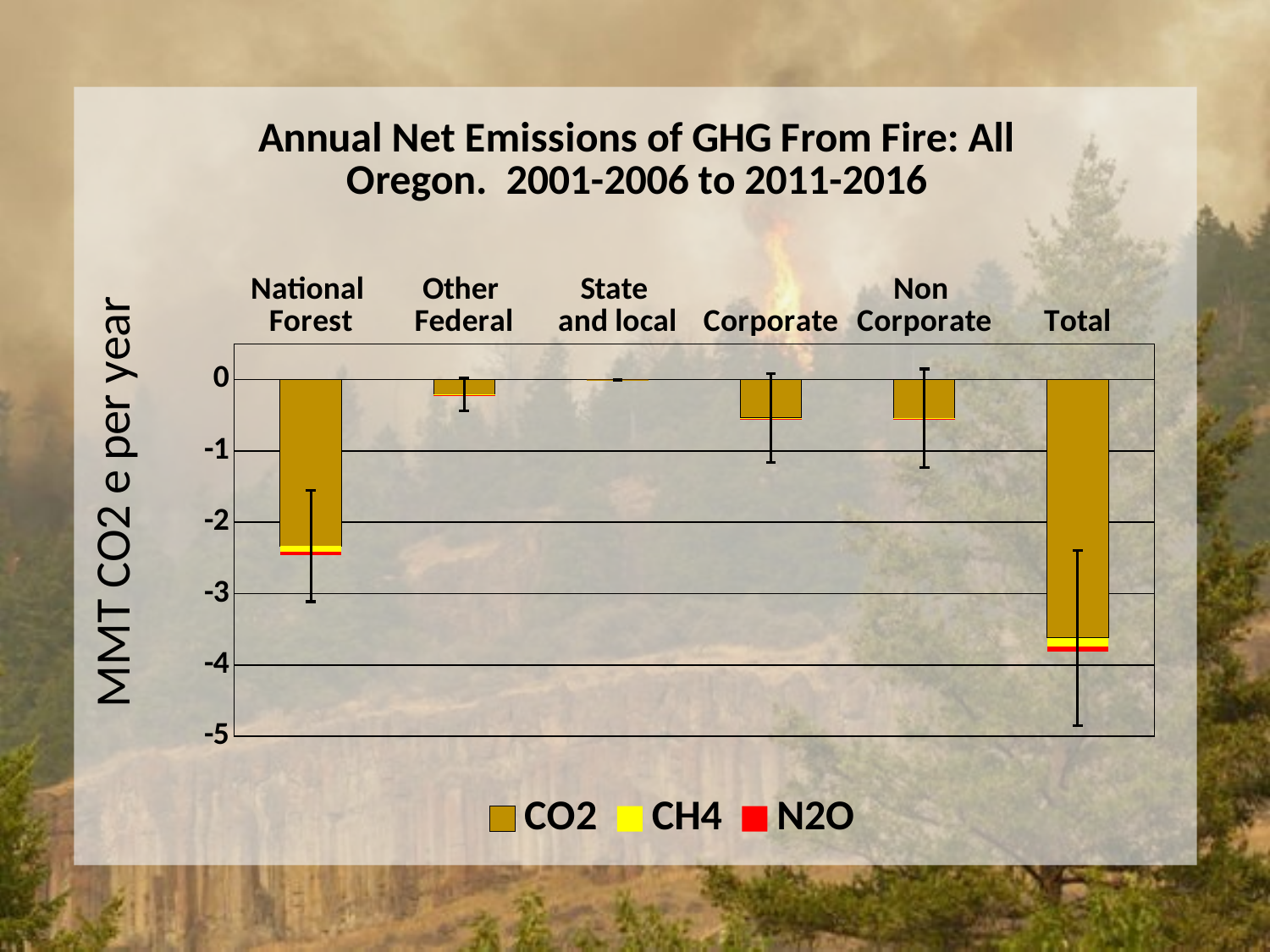
What kind of chart is shown on the slide? bar chart How many series does the legend list? 3 Which bar extends further below zero, National Forest or Other Federal? National Forest Is the value for National Forest greater or less than -2? less What are the three series listed in the chart legend? CO2, CH4, N2O What is the label on the vertical axis of the chart? MMT CO2 e per year Is the value for Total greater or less than -3? less Is the value for Corporate greater or less than -1? greater How many categories are shown along the x axis of the chart? 6 Which category has the bar that extends furthest below zero? Total Which category has the bar closest to zero? State and local